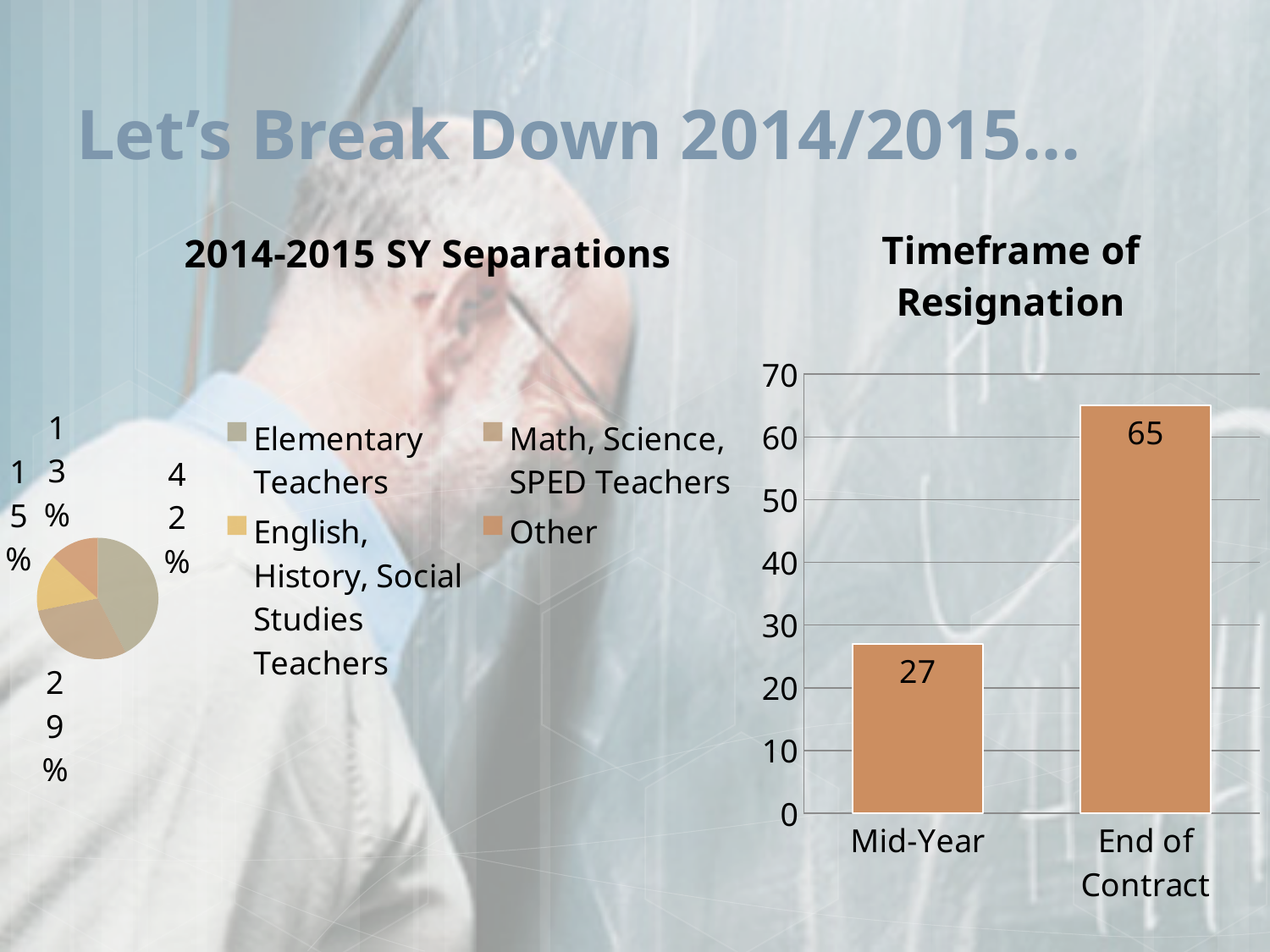
What kind of chart is the 2014-2015 SY Separations chart? pie chart In the Timeframe of Resignation chart, what is the value for End of Contract? 65 In the Timeframe of Resignation chart, what is the value for Mid-Year? 27 In the Timeframe of Resignation chart, is the value for Mid-Year greater or less than 30? less In the Timeframe of Resignation chart, how many categories are shown on the x axis? 2 In the 2014-2015 SY Separations chart, which legend category has the largest slice? Elementary Teachers In the Timeframe of Resignation chart, which category has the highest value? End of Contract What kind of chart is the Timeframe of Resignation chart? bar chart In the Timeframe of Resignation chart, what is the difference between the End of Contract and Mid-Year values? 38 In the Timeframe of Resignation chart, which category has the lowest value? Mid-Year In the 2014-2015 SY Separations chart, what share of the pie is the largest slice? 42% In the 2014-2015 SY Separations chart, how many entries does the legend list? 4